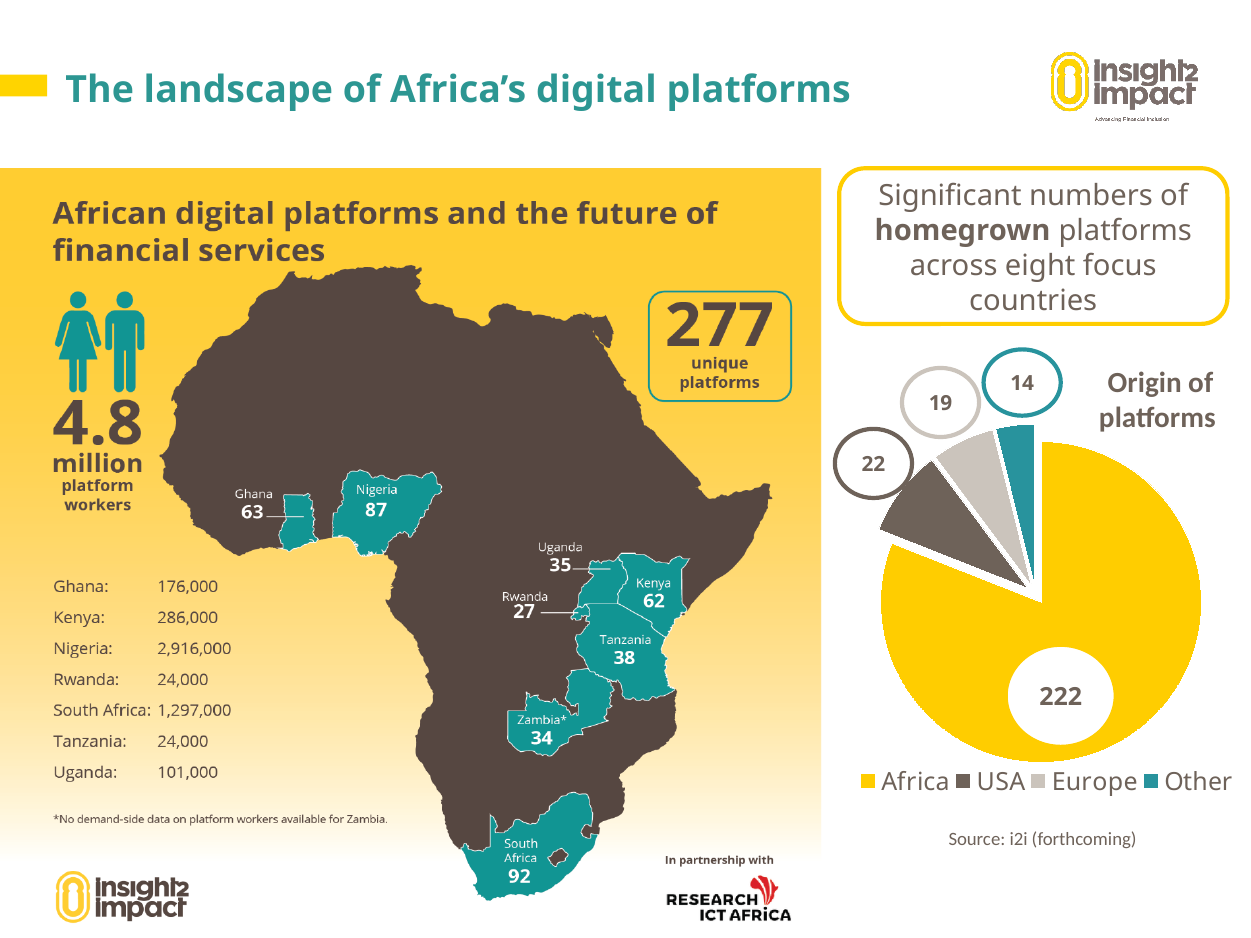
In the 'Origin of platforms' pie chart, which category has the largest slice? Africa In the 'Origin of platforms' pie chart, what colour is the Africa slice? Yellow In the 'Origin of platforms' pie chart, which category has the smallest slice? Other In the 'Origin of platforms' pie chart, which is larger, the Europe slice or the Other slice? Europe In the 'Origin of platforms' pie chart, what is the value for Europe? 19 What type of chart is the 'Origin of platforms' chart? Pie chart In the 'Origin of platforms' pie chart, what is the value for USA? 22 In the 'Origin of platforms' pie chart, what is the value for Other? 14 In the 'Origin of platforms' pie chart, what is the difference between the USA value and the Europe value? 3 In the 'Origin of platforms' pie chart, what is the value for Africa? 222 In the 'Origin of platforms' pie chart, what is the difference between the Africa value and the USA value? 200 How many categories does the 'Origin of platforms' pie chart show? 4